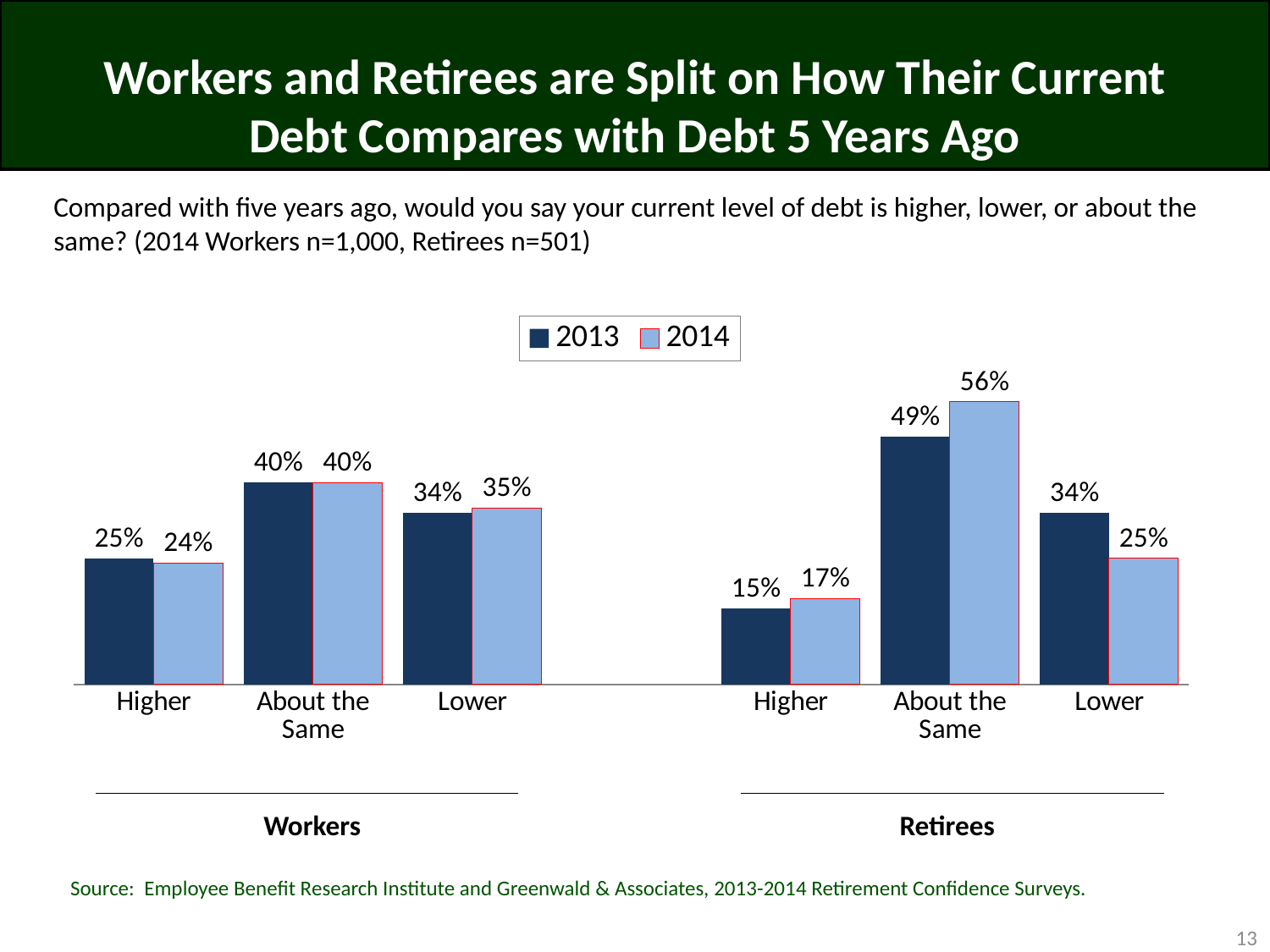
Which two years are listed in the chart legend? 2013 and 2014 What percentage of Retirees said their debt was about the same in 2014? 56% What is the difference between the 2014 and 2013 values for Retirees who said their debt was about the same? 7 percentage points What type of chart is shown on the slide? Bar chart What is the difference between the 2013 and 2014 values for Retirees who said their debt was lower? 9 percentage points Which is larger: the 2014 value for Workers who said 'Lower' or the 2014 value for Retirees who said 'Lower'? Workers (35%) How many response categories are shown for each group (Workers and Retirees)? 3 Among Workers in 2014, which response had the highest percentage? About the Same How many series does the legend list? 2 What percentage of Workers said their debt was lower in 2013? 34% Among Retirees in 2013, which response had the lowest percentage? Higher What percentage of Retirees said their debt was higher in 2013? 15%